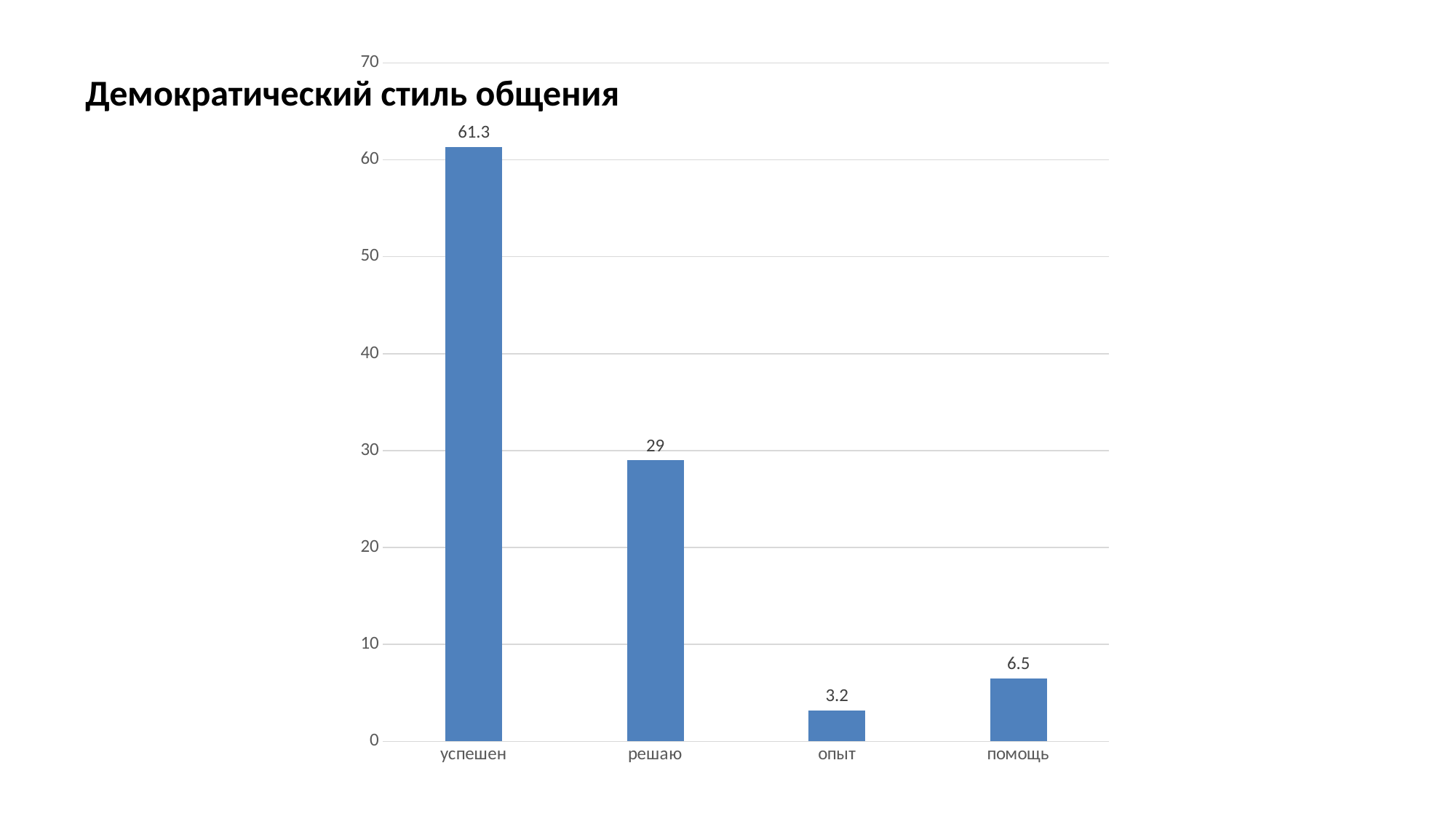
What is the value for опыт? 3.2 Which category has the highest value? успешен What is the title of the slide? Демократический стиль общения What is the value for решаю? 29 What is the difference between the values for успешен and решаю? 32.3 What is the value for успешен? 61.3 What is the value for помощь? 6.5 Which is larger, the value for помощь or the value for опыт? помощь Which category has the lowest value? опыт How many categories are shown on the x axis? 4 What kind of chart is shown on the slide? bar chart Is the value for решаю greater or less than 30? less